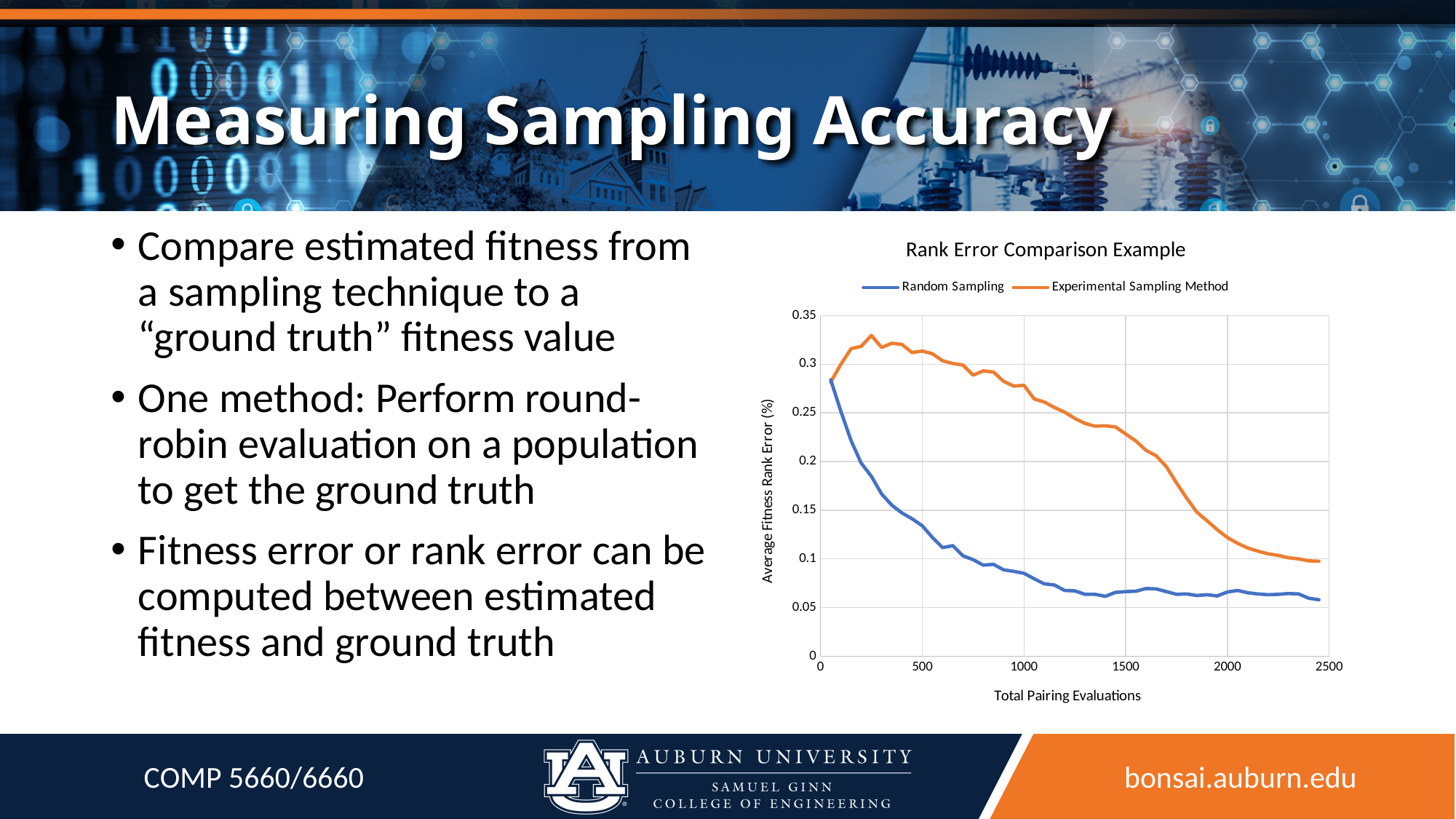
At 1500 Total Pairing Evaluations, which series has the lower Average Fitness Rank Error, Random Sampling or Experimental Sampling Method? Random Sampling Is the value for Random Sampling at 1000 Total Pairing Evaluations greater or less than 0.1? less What is the label of the y axis of the chart? Average Fitness Rank Error (%) Is the value for Experimental Sampling Method at 1500 Total Pairing Evaluations greater or less than 0.2? greater Does the Experimental Sampling Method series rise or fall overall from 500 to 2500 Total Pairing Evaluations? fall What kind of chart is shown on the slide? line chart Does the Random Sampling series rise or fall as Total Pairing Evaluations increases? fall At 1000 Total Pairing Evaluations, which series has the higher Average Fitness Rank Error, Random Sampling or Experimental Sampling Method? Experimental Sampling Method Is the value for Experimental Sampling Method at 500 Total Pairing Evaluations greater or less than 0.3? greater How many series does the legend of the chart list? 2 What is the title of the chart? Rank Error Comparison Example